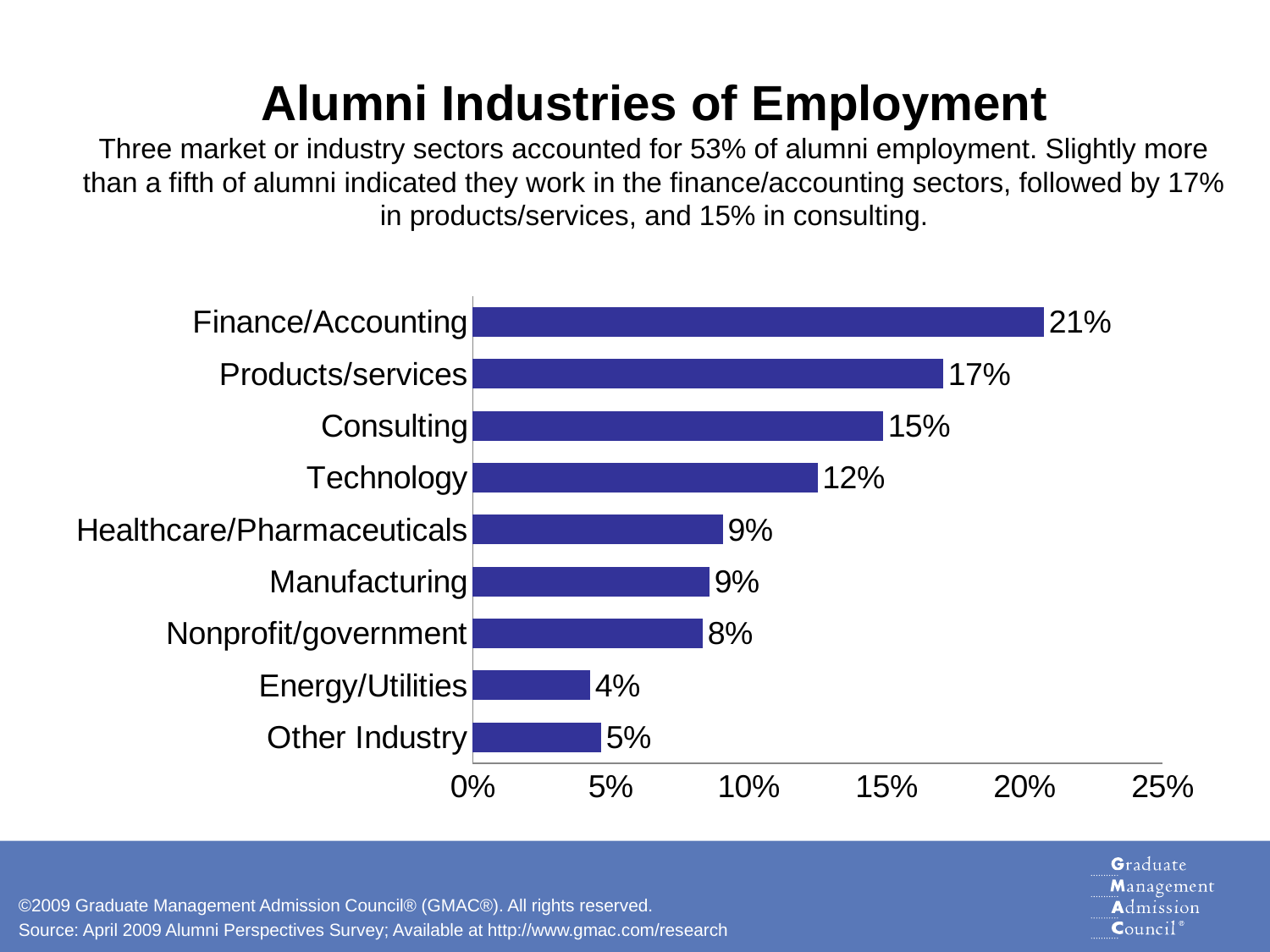
What percentage of alumni work in Finance/Accounting? 21% What is the difference between the Products/services and Technology values? 5% Which is larger, the value for Other Industry or the value for Energy/Utilities? Other Industry What is the value shown for Technology? 12% How many industry categories are shown in the chart? 9 What type of chart is shown on the slide? Bar chart What is the title of the slide? Alumni Industries of Employment What percentage is shown for Nonprofit/government? 8% What is the difference between the Finance/Accounting and Consulting percentages? 6% Is the value for Consulting greater or less than 10%? greater Which industry has the lowest share of alumni employment? Energy/Utilities Which industry has the highest share of alumni employment? Finance/Accounting